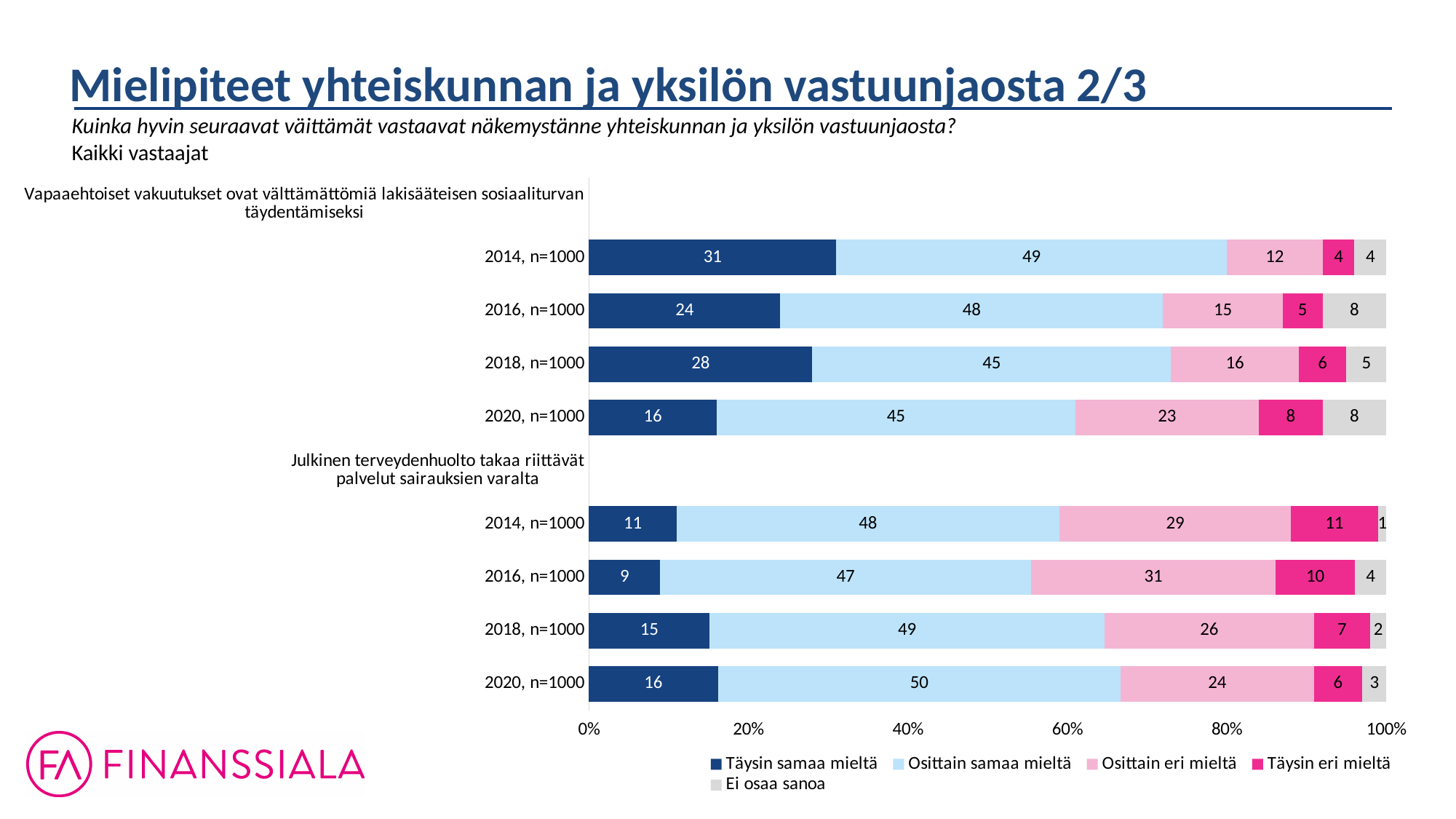
What is the 'Täysin samaa mieltä' value for 2014, n=1000 under 'Vapaaehtoiset vakuutukset ovat välttämättömiä lakisääteisen sosiaaliturvan täydentämiseksi'? 31 Which year has the highest 'Täysin samaa mieltä' value under 'Vapaaehtoiset vakuutukset ovat välttämättömiä lakisääteisen sosiaaliturvan täydentämiseksi'? 2014, n=1000 Which is larger: the 'Osittain samaa mieltä' value for 2020 under 'Julkinen terveydenhuolto takaa riittävät palvelut sairauksien varalta' or for 2020 under 'Vapaaehtoiset vakuutukset ovat välttämättömiä lakisääteisen sosiaaliturvan täydentämiseksi'? Julkinen terveydenhuolto (50) What kind of chart is shown on the slide? Stacked bar chart What is the 'Osittain eri mieltä' value for 2016, n=1000 under 'Julkinen terveydenhuolto takaa riittävät palvelut sairauksien varalta'? 31 How many bars are plotted in the chart in total? 8 What is the total of the 'Täysin samaa mieltä' and 'Osittain samaa mieltä' segments for 2018, n=1000 under 'Julkinen terveydenhuolto takaa riittävät palvelut sairauksien varalta'? 64 What is the difference between the 'Osittain eri mieltä' values for 2020 and 2014 under 'Vapaaehtoiset vakuutukset ovat välttämättömiä lakisääteisen sosiaaliturvan täydentämiseksi'? 11 How many series does the legend list? 5 What is the 'Ei osaa sanoa' value for 2020, n=1000 under 'Vapaaehtoiset vakuutukset ovat välttämättömiä lakisääteisen sosiaaliturvan täydentämiseksi'? 8 Which year has the lowest 'Täysin samaa mieltä' value under 'Julkinen terveydenhuolto takaa riittävät palvelut sairauksien varalta'? 2016, n=1000 Which legend entry is shown in grey? Ei osaa sanoa